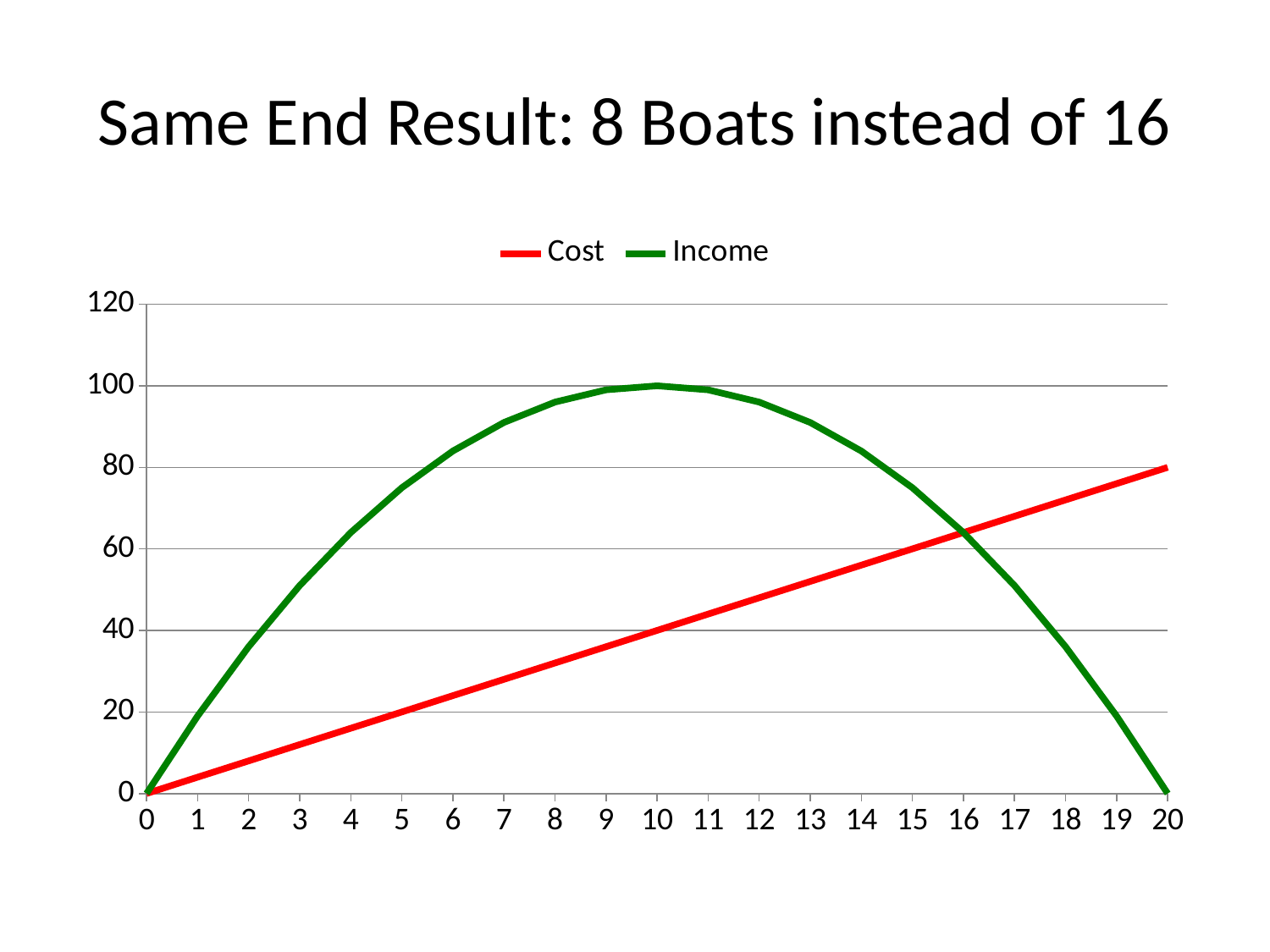
What is the Cost value at x = 20? 80 At which x value does the Income line reach its highest point? 10 What is the title of the slide? Same End Result: 8 Boats instead of 16 What is the Income value at x = 10? 100 Which series has the larger value at x = 10, Cost or Income? Income How many series does the legend list? 2 What are the names of the two series in the legend? Cost and Income What is the Cost value at x = 10? 40 Which series has the larger value at x = 18, Cost or Income? Cost What is the Income value at x = 20? 0 Does the Cost line rise or fall as x increases from 0 to 20? rise What kind of chart is shown on the slide? line chart